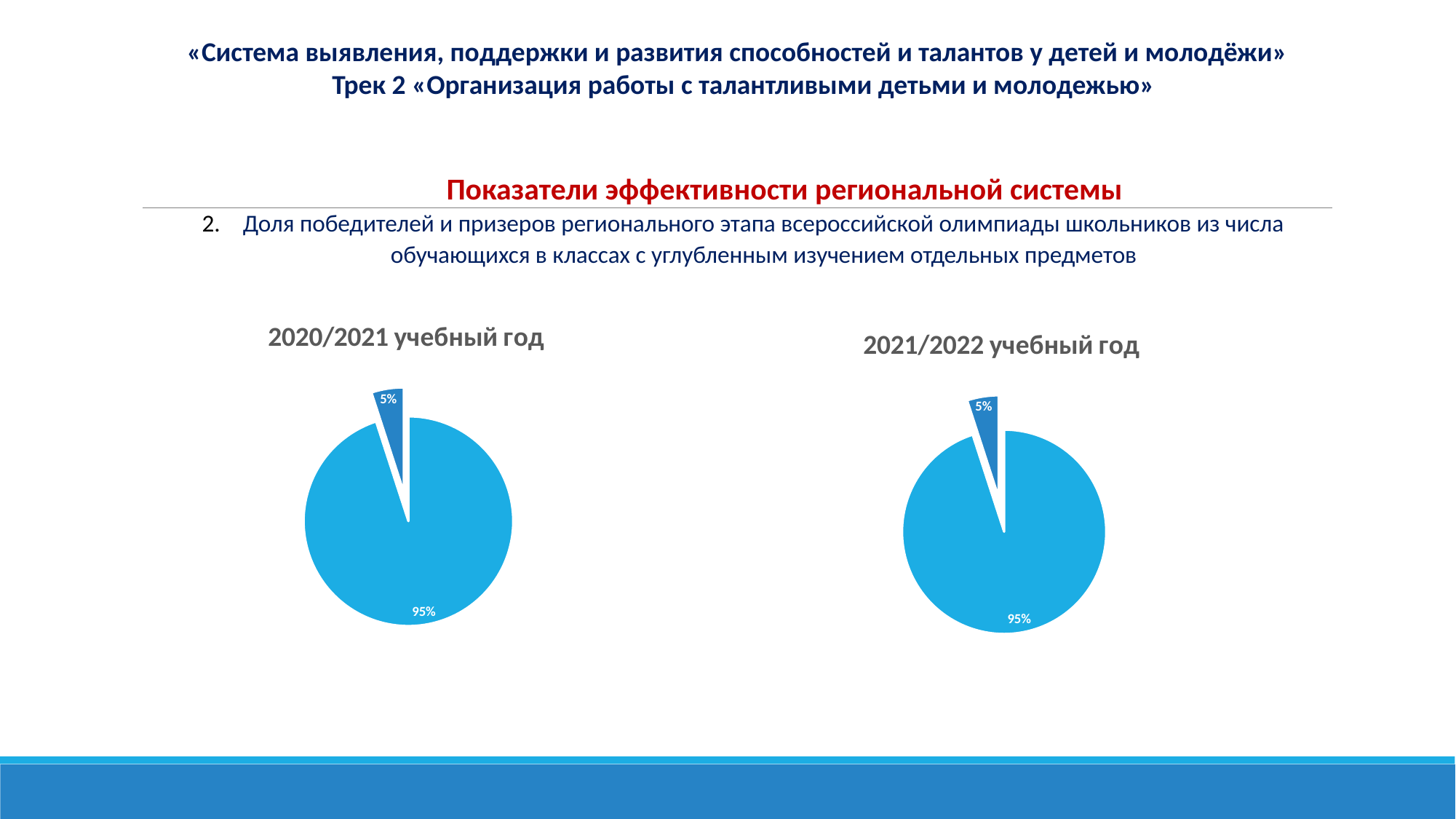
What kind of chart is the "2021/2022 учебный год" chart? pie chart In the "2021/2022 учебный год" chart, what percentage is shown on the large light-blue slice? 95% In the "2020/2021 учебный год" chart, what percentage is shown on the small dark-blue exploded slice? 5% In the "2020/2021 учебный год" chart, what is the difference between the large slice and the small slice? 90% In the "2020/2021 учебный год" chart, what percentage is shown on the large light-blue slice? 95% How many pie charts are shown on the slide? 2 How many slices does the "2020/2021 учебный год" pie chart have? 2 What is the title of the pie chart on the right side of the slide? 2021/2022 учебный год How many slices does the "2021/2022 учебный год" pie chart have? 2 What kind of chart is the "2020/2021 учебный год" chart? pie chart In the "2021/2022 учебный год" chart, which slice is larger, the light-blue one or the dark-blue one? the light-blue one In the "2021/2022 учебный год" chart, what percentage is shown on the small dark-blue exploded slice? 5%